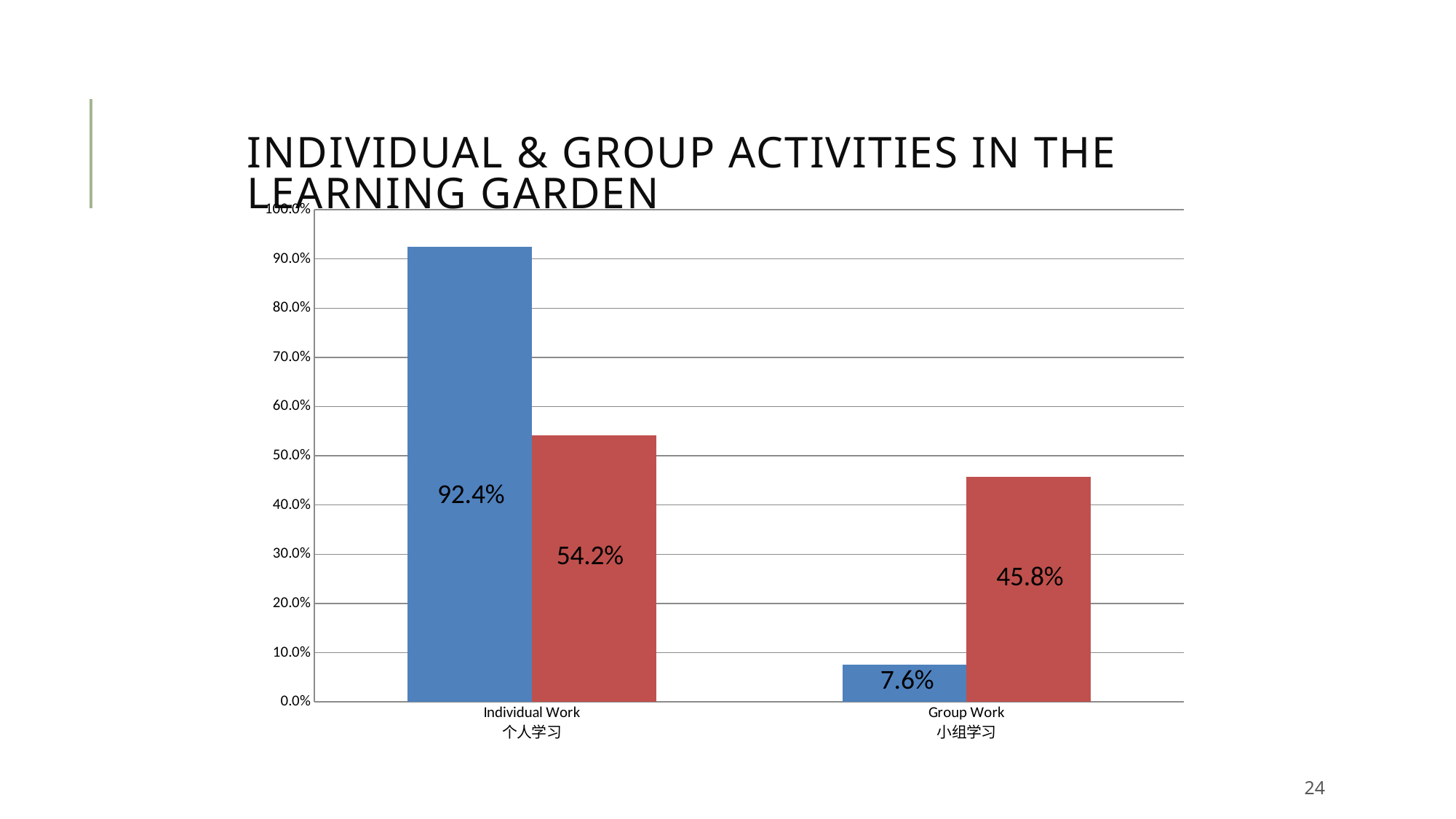
Which category has the lowest red bar? Group Work For Group Work, which bar is larger, the blue or the red? red What kind of chart is shown on the slide? bar chart What is the value of the red bar for Group Work? 45.8% How many categories are shown on the x axis? 2 What is the value of the red bar for Individual Work? 54.2% Which category has the highest blue bar? Individual Work What is the difference between the blue bars for Individual Work and Group Work? 84.8% What is the value of the blue bar for Group Work? 7.6% Is the blue bar for Individual Work greater or less than 90.0%? greater What is the value of the blue bar for Individual Work? 92.4% What is the difference between the red bars for Individual Work and Group Work? 8.4%